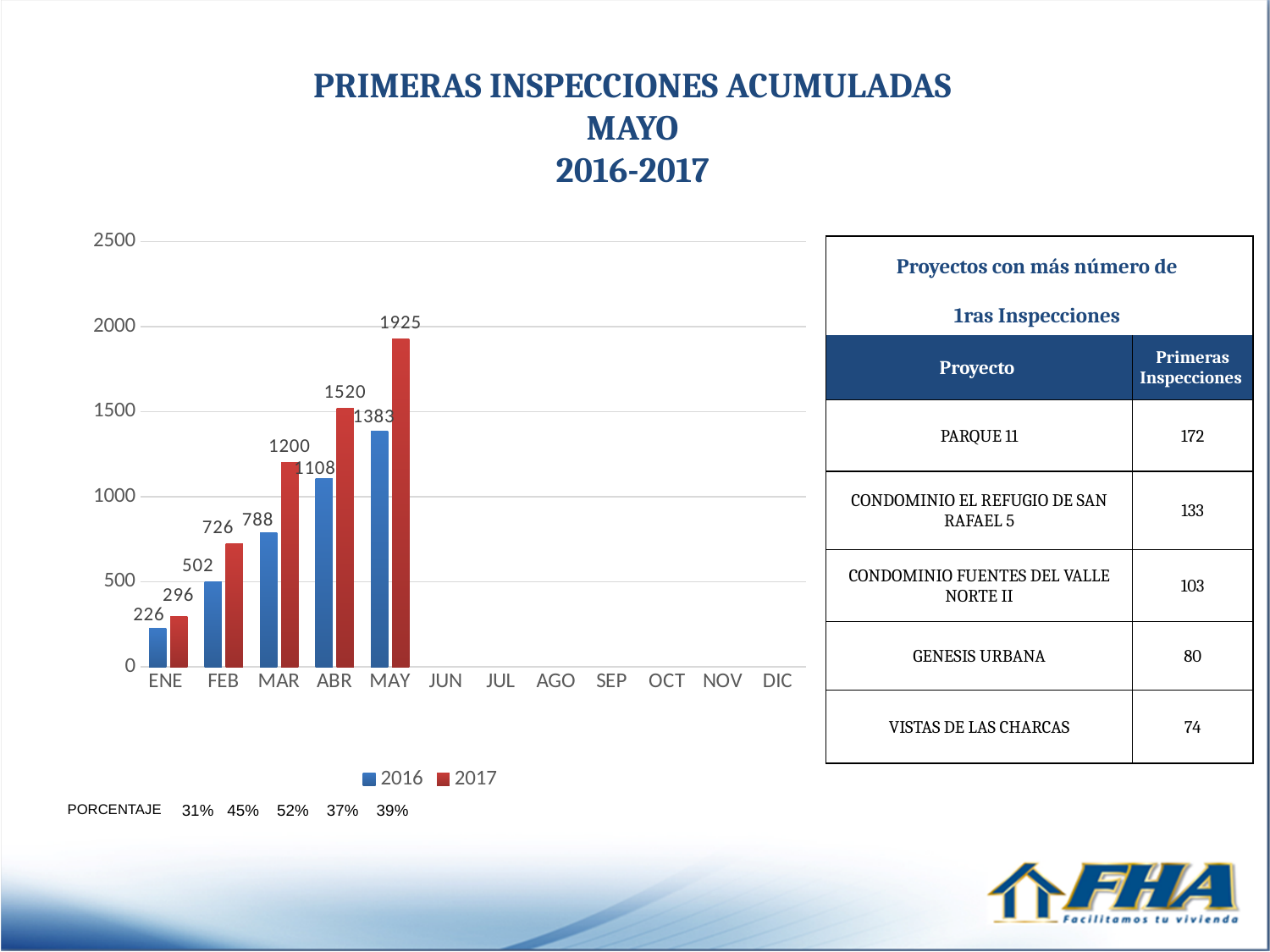
Which month has the highest value for the 2017 series? MAY What is the value for 2016 in ENE? 226 What is the difference between the 2017 and 2016 values in MAR? 412 Is the value for 2017 in MAY greater or less than 2000? less What kind of chart is shown on the slide? bar chart What is the value for 2017 in FEB? 726 Which month has the lowest value for the 2016 series among the months with data? ENE How many series does the legend list? 2 Do the 2016 values rise or fall from ENE to MAY? rise What is the value for 2016 in ABR? 1108 What is the value for 2017 in MAY? 1925 Which is larger in ABR, the 2016 value or the 2017 value? 2017